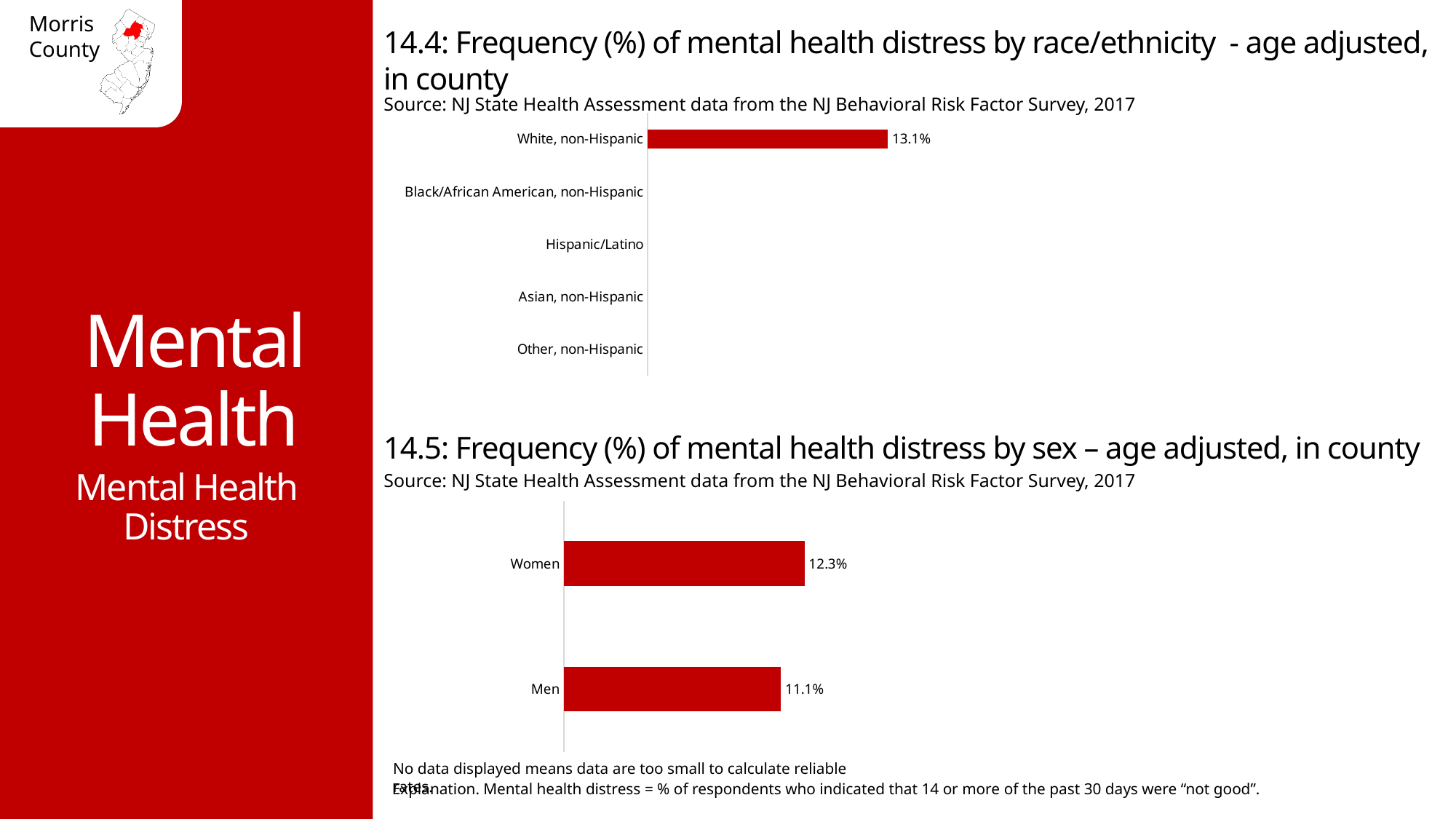
In chart 14.4 (mental health distress by race/ethnicity), how many race/ethnicity categories are listed on the axis? 5 In chart 14.5 (mental health distress by sex), which category has the lower value? Men In chart 14.5 (mental health distress by sex), how many categories are shown? 2 In chart 14.5 (mental health distress by sex), what is the difference between the values for Women and Men? 1.2% In chart 14.5 (mental health distress by sex), what is the value for Men? 11.1% What kind of chart is chart 14.5 (mental health distress by sex)? Bar chart In chart 14.5 (mental health distress by sex), what is the value for Women? 12.3% In chart 14.4 (mental health distress by race/ethnicity), what is the value for White, non-Hispanic? 13.1% What kind of chart is chart 14.4 (mental health distress by race/ethnicity)? Bar chart In chart 14.5 (mental health distress by sex), which category has the higher value? Women In chart 14.4 (mental health distress by race/ethnicity), which category is the only one with a bar displayed? White, non-Hispanic In chart 14.5 (mental health distress by sex), is the value for Women larger or smaller than the value for Men? Larger